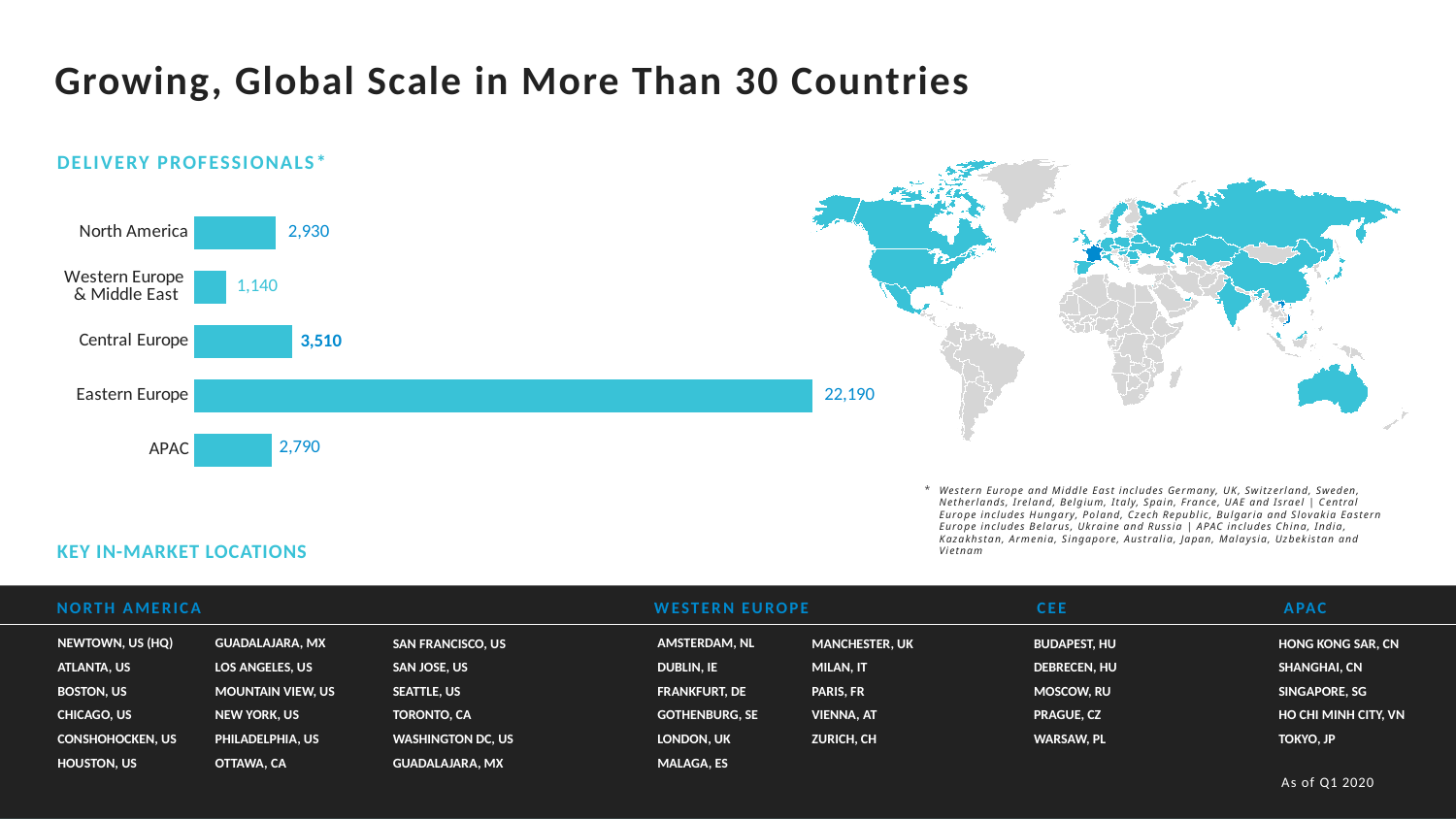
What is the value for Western Europe & Middle East in the Delivery Professionals chart? 1,140 Which region has the highest number of delivery professionals? Eastern Europe What kind of chart is the Delivery Professionals chart? Bar chart What is the value for Central Europe in the Delivery Professionals chart? 3,510 What is the title of the chart on the slide? Delivery Professionals* What is the value for Eastern Europe in the Delivery Professionals chart? 22,190 What is the difference between the values for North America and APAC in the Delivery Professionals chart? 140 How many regions are shown in the Delivery Professionals chart? 5 Which region has the lowest number of delivery professionals? Western Europe & Middle East What is the value for APAC in the Delivery Professionals chart? 2,790 Which is larger in the Delivery Professionals chart, Central Europe or North America? Central Europe What is the difference between the values for Eastern Europe and Central Europe in the Delivery Professionals chart? 18,680